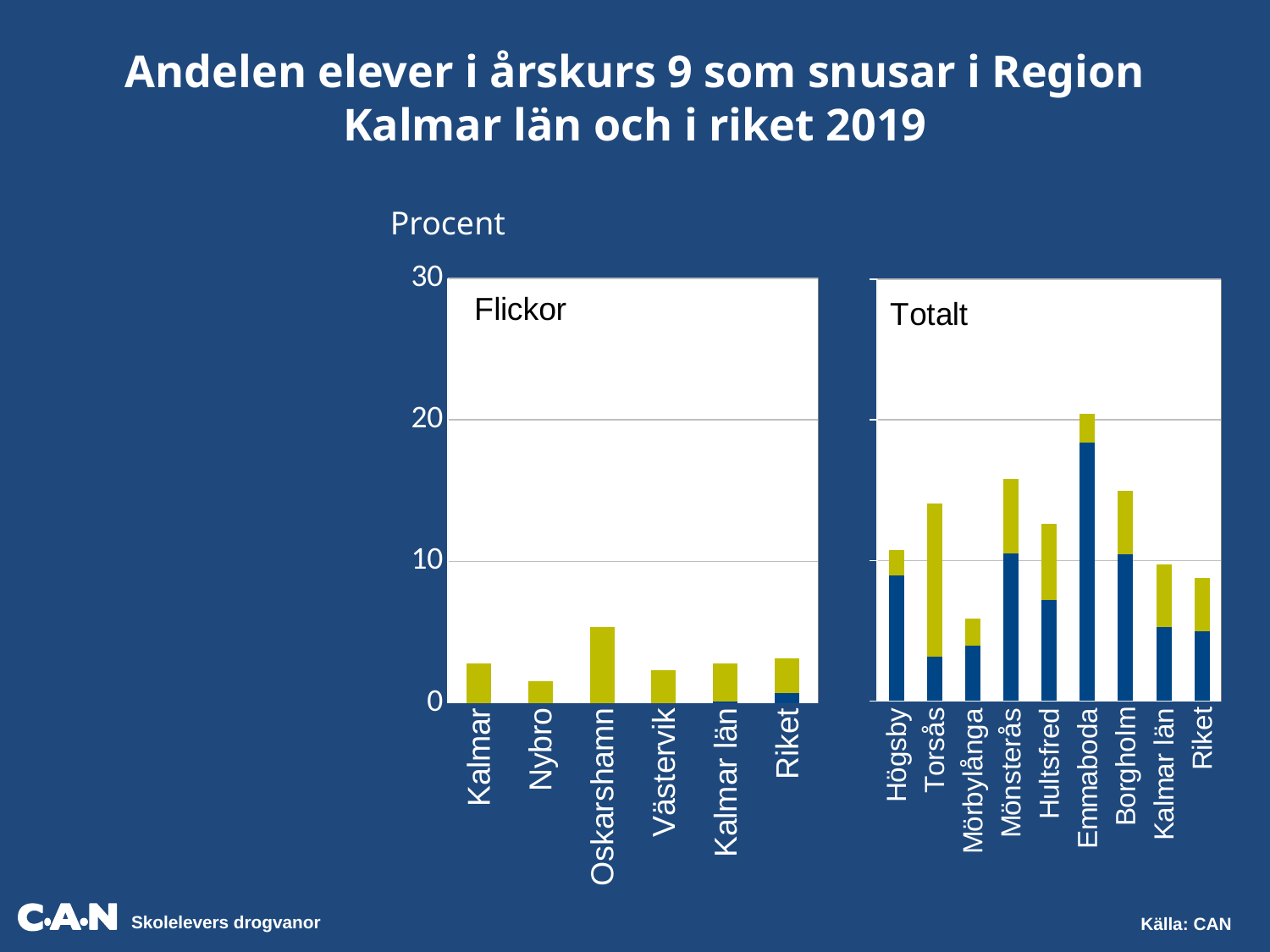
In the Totalt chart, is the value for Mörbylånga greater or less than 10? less How many categories are shown on the x axis of the Flickor chart? 6 In the Totalt chart, is the value for Riket greater or less than 10? less In the Totalt chart, which is larger, the value for Mönsterås or the value for Riket? Mönsterås In the Totalt chart, which category has the highest bar? Emmaboda What label is shown on the vertical axis of the charts? Procent In the Totalt chart, which category has the lowest bar? Mörbylånga In the Totalt chart, is the value for Torsås greater or less than 10? greater How many categories are shown on the x axis of the Totalt chart? 9 In the Flickor chart, which category has the lowest bar? Nybro In the Flickor chart, which category has the highest bar? Oskarshamn What kind of chart is the Totalt chart on the slide? bar chart